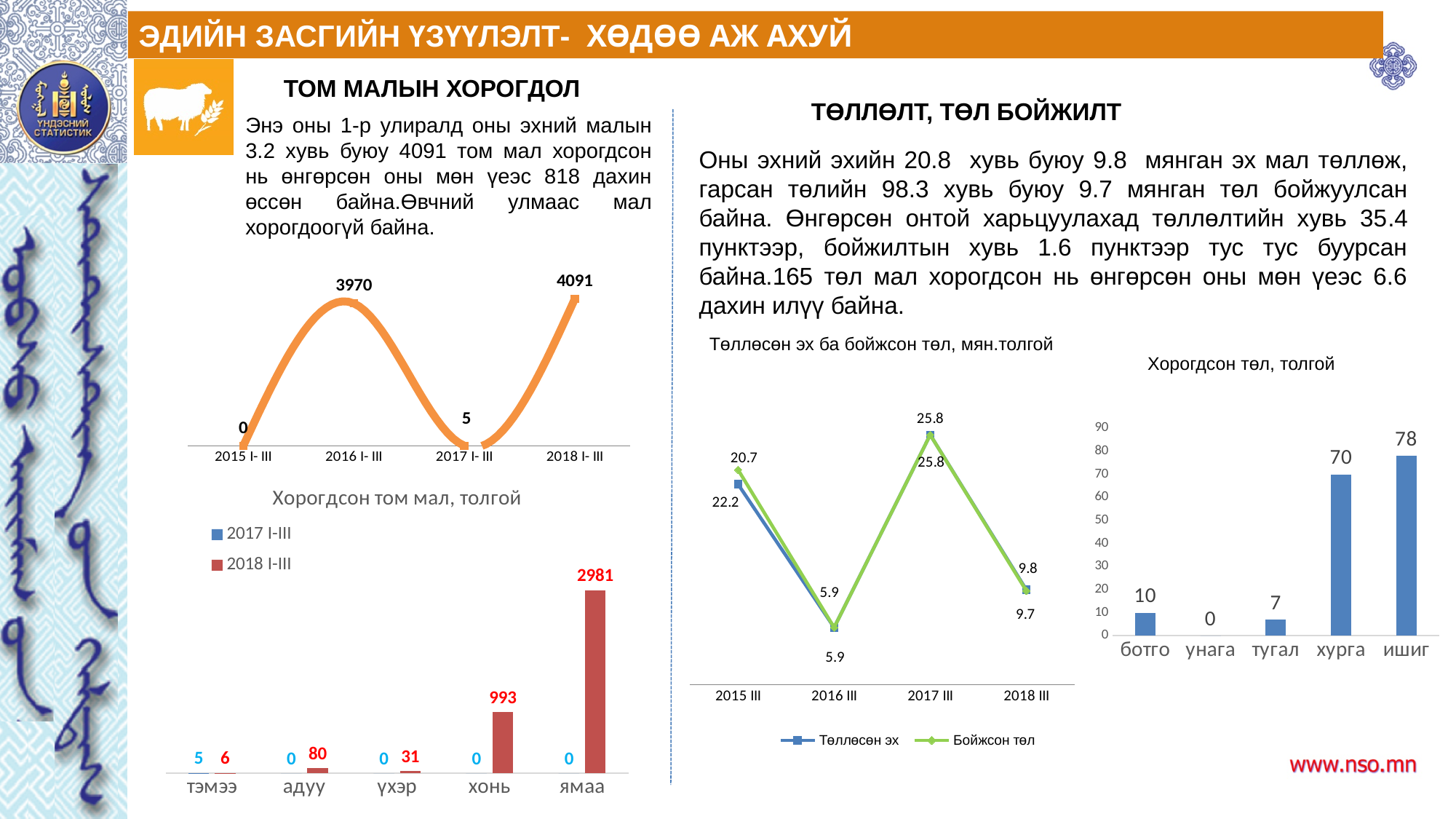
In the chart titled 'Хорогдсон том мал, толгой', what kind of chart is it? bar chart In the chart titled 'Төллөсөн эх ба бойжсон төл, мян.толгой', what is the value of Төллөсөн эх for 2018 III? 9.8 In the chart titled 'Хорогдсон төл, толгой', what is the value for ишиг? 78 In the chart titled 'Хорогдсон том мал, толгой', what is the 2018 I-III value for адуу? 80 In the chart titled 'Хорогдсон төл, толгой', which category has the lowest value? унага In the chart titled 'Хорогдсон том мал, толгой', which category has the highest 2018 I-III value? ямаа In the chart titled 'Хорогдсон төл, толгой', what is the difference between the values for ишиг and хурга? 8 In the chart titled 'Хорогдсон том мал, толгой', how many series does the legend list? 2 In the chart titled 'Хорогдсон төл, толгой', how many categories are shown on the x axis? 5 In the orange line chart at the top left of the slide, what is the difference between the values for 2018 I- III and 2016 I- III? 121 In the orange line chart at the top left of the slide, what is the value for 2018 I- III? 4091 In the chart titled 'Хорогдсон том мал, толгой', what is the 2018 I-III value for ямаа? 2981